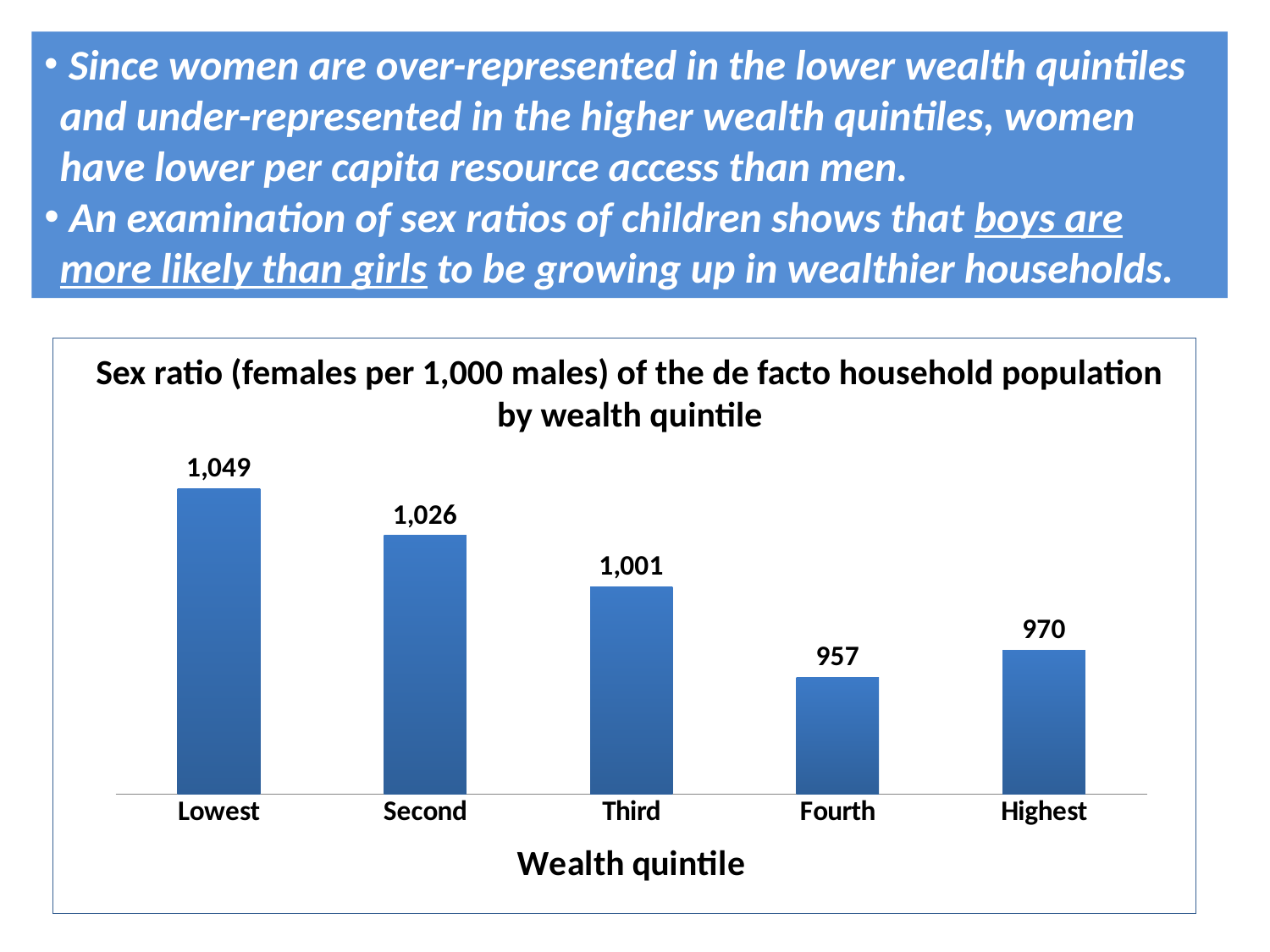
What is the sex ratio for the Lowest wealth quintile? 1,049 How many wealth quintile categories are shown in the chart? 5 What is the difference between the sex ratio of the Lowest quintile and the Highest quintile? 79 What is the difference between the sex ratio of the Second quintile and the Third quintile? 25 Which wealth quintile has the highest sex ratio? Lowest What is the sex ratio for the Fourth wealth quintile? 957 What kind of chart is shown on the slide? Bar chart Which has a larger sex ratio, the Fourth quintile or the Highest quintile? Highest Does the sex ratio generally rise or fall from the Lowest to the Fourth wealth quintile? Fall Which wealth quintile has the lowest sex ratio? Fourth What is the sex ratio for the Highest wealth quintile? 970 What is the label of the x axis of the chart? Wealth quintile